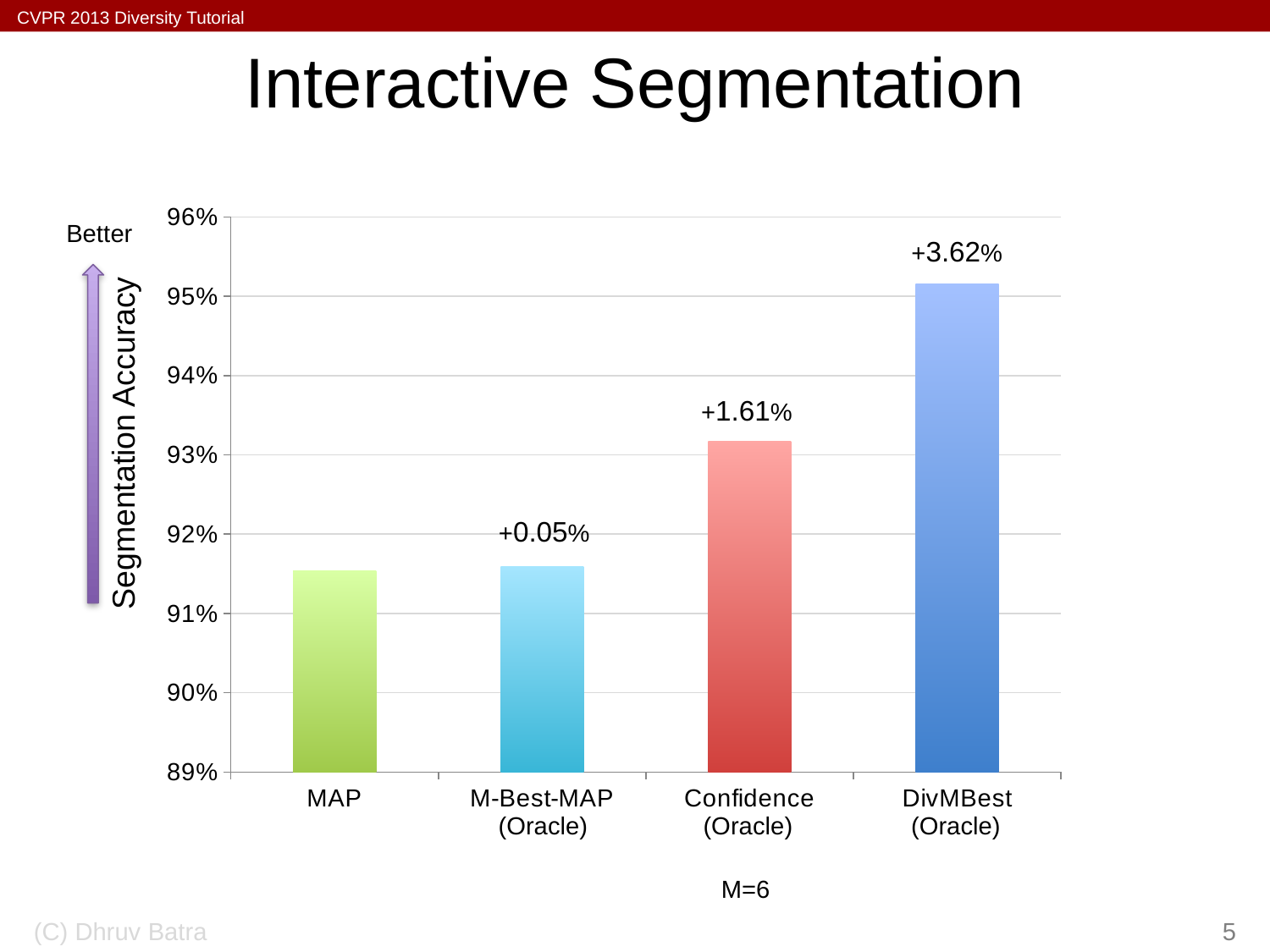
Which category has the highest segmentation accuracy? DivMBest (Oracle) How many categories (bars) are shown in the chart? 4 Is the segmentation accuracy for Confidence (Oracle) greater or less than 93%? greater What kind of chart is shown on the slide? bar chart Which has a higher segmentation accuracy, MAP or Confidence (Oracle)? Confidence (Oracle) What improvement label is printed above the DivMBest (Oracle) bar? +3.62% What improvement label is printed above the Confidence (Oracle) bar? +1.61% By how much does the printed improvement for DivMBest (Oracle) exceed the printed improvement for Confidence (Oracle)? 2.01% What improvement label is printed above the M-Best-MAP (Oracle) bar? +0.05% What is the label on the vertical axis of the chart? Segmentation Accuracy Is the segmentation accuracy for DivMBest (Oracle) greater or less than 95%? greater Is the segmentation accuracy for MAP greater or less than 92%? less